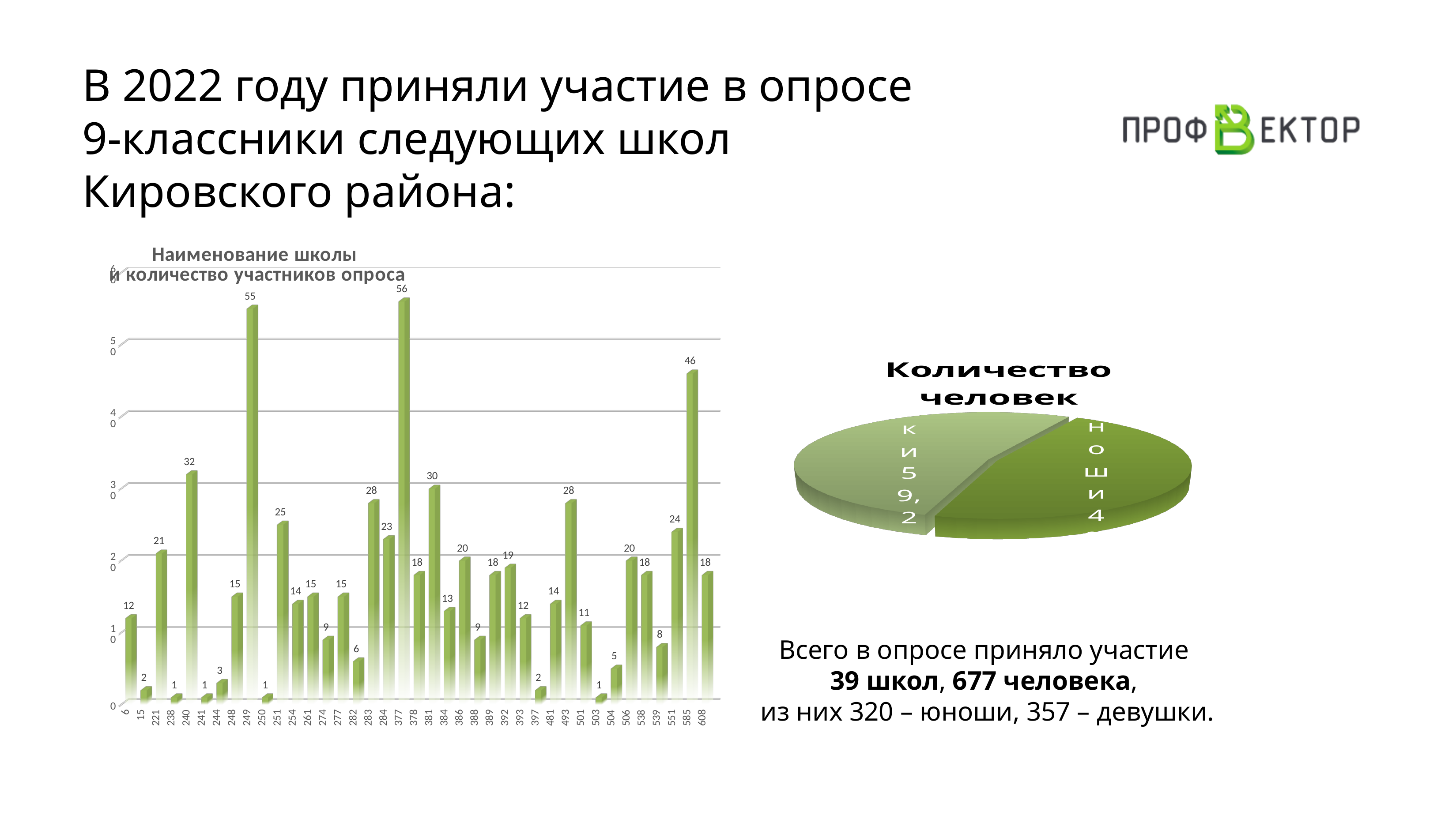
In the bar chart, what is the value for school 585? 46 In the bar chart, what is the difference between the values for school 377 and school 249? 1 What type of chart is the chart on the right of the slide? pie chart In the bar chart, which is larger: the value for school 381 or the value for school 283? 381 In the bar chart, what is the value for school 249? 55 How many schools (categories) are shown in the bar chart? 39 In the bar chart, is the value for school 585 greater or less than 40? greater In the bar chart, what is the difference between the values for school 251 and school 254? 11 In the bar chart, which school has the highest number of survey participants? 377 What type of chart is the chart on the left of the slide? bar chart In the bar chart, what is the value for school 240? 32 What is the title of the chart on the right of the slide? Количество человек